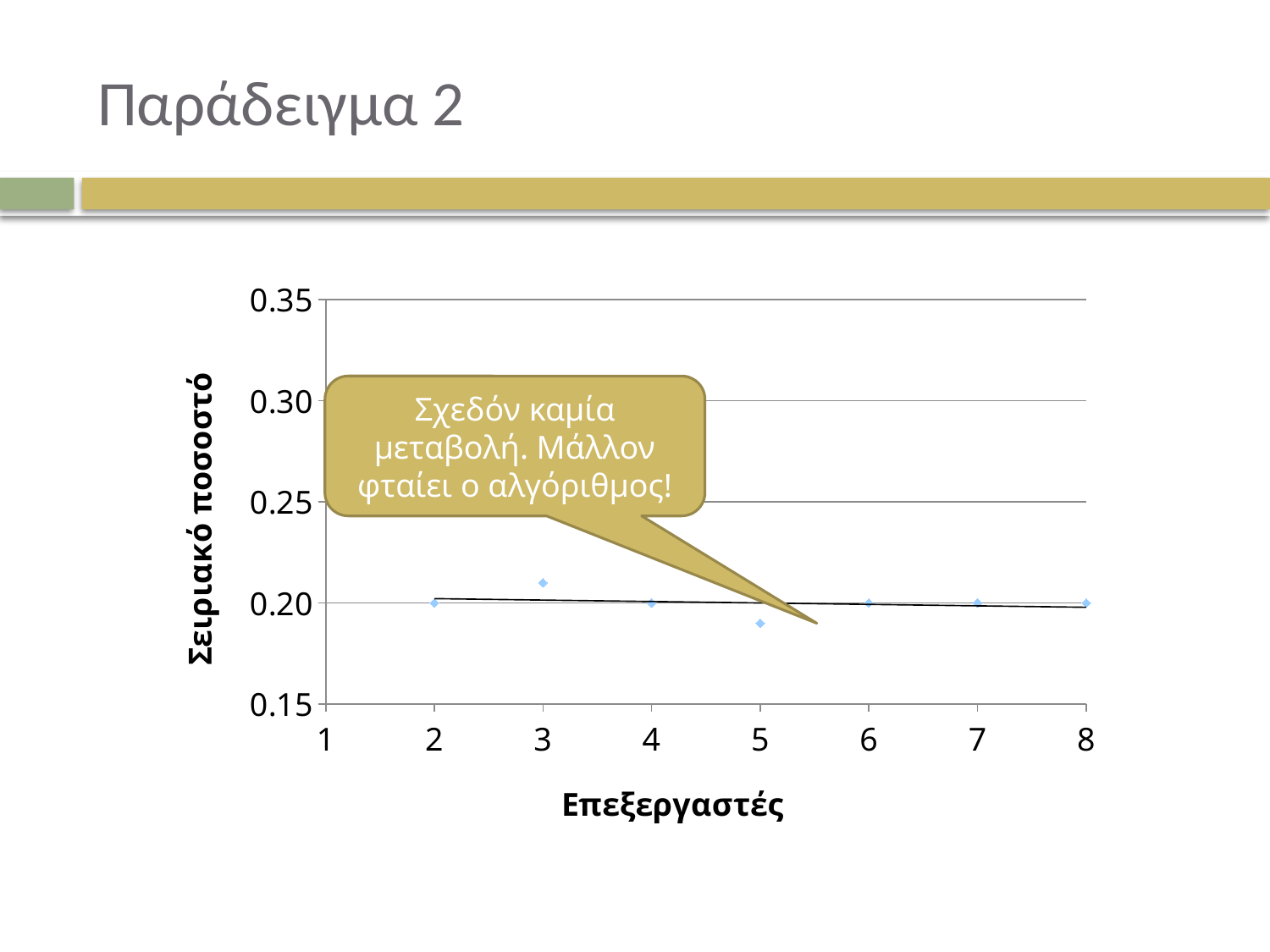
Is the value for 5 processors greater or less than 0.20? less What is the plotted value for 2 processors? 0.20 At which number of processors (Επεξεργαστές) is the plotted value highest? 3 Which is larger, the value for 3 processors or the value for 5 processors? 3 processors Is the value for 3 processors greater or less than 0.20? greater What is the title of the x axis of the chart? Επεξεργαστές Do the plotted values show a strong rising or falling trend as the number of processors increases, or do they stay roughly flat? Roughly flat Is the value for 3 processors greater or less than 0.25? less How many data points are plotted in the chart? 7 What kind of chart is shown on the slide? Scatter chart At which number of processors (Επεξεργαστές) is the plotted value lowest? 5 What is the title of the y axis of the chart? Σειριακό ποσοστό